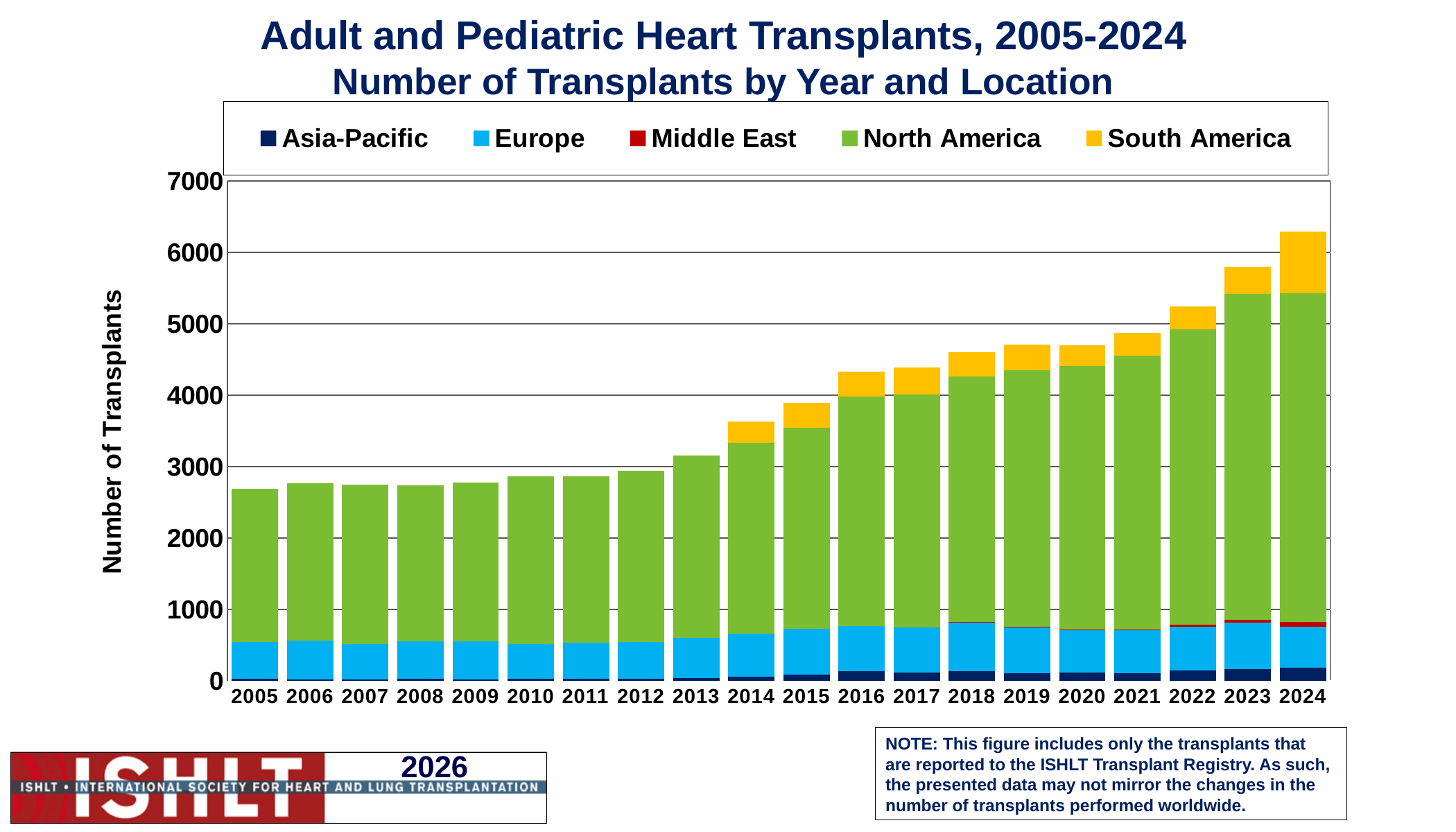
Do the total number of transplants generally rise or fall from 2005 to 2024? Rise How many years are shown along the x axis? 20 In which year does the South America segment first appear in the bars? 2014 What kind of chart is shown on the slide? Stacked bar chart How many series does the legend list? 5 Is the total number of transplants in 2005 greater or less than 3000? less Which year has the larger total number of transplants, 2019 or 2022? 2022 Is the total number of transplants in 2016 greater or less than 4000? greater Is the total number of transplants in 2023 greater or less than 6000? less Which year has the highest total number of transplants? 2024